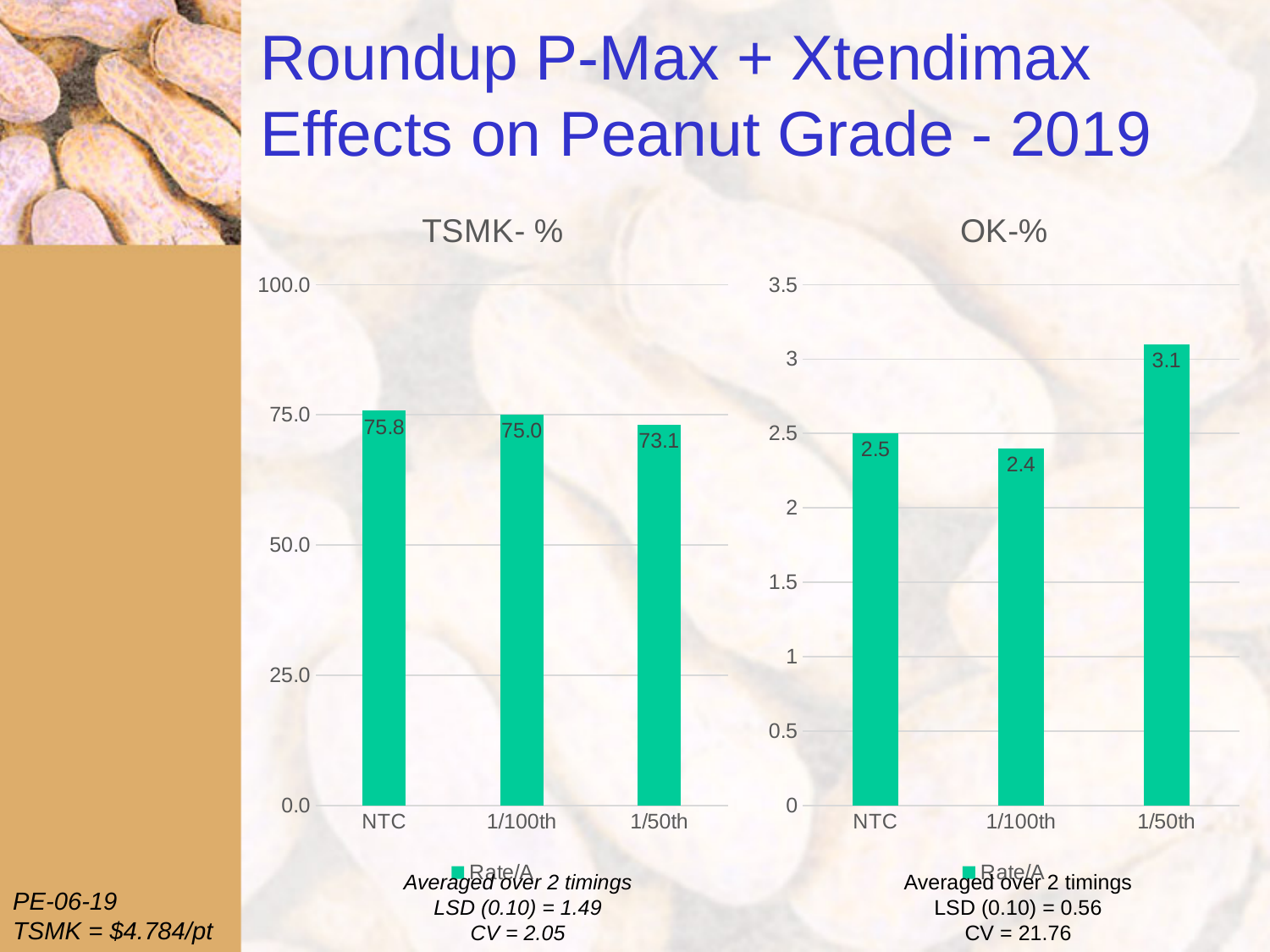
In the OK-% chart, which category has the lowest value? 1/100th In the TSMK- % chart, which category has the highest value? NTC In the OK-% chart, what is the value for 1/50th? 3.1 How many categories are shown on the x axis of the OK-% chart? 3 In the TSMK- % chart, what is the value for NTC? 75.8 What kind of chart is the TSMK- % chart? Bar chart In the TSMK- % chart, what is the difference between the NTC value and the 1/50th value? 2.7 In the OK-% chart, what is the difference between the 1/50th value and the NTC value? 0.6 In the OK-% chart, what is the value for 1/100th? 2.4 In the TSMK- % chart, what is the value for 1/50th? 73.1 What is the legend entry shown below the OK-% chart? Rate/A In the TSMK- % chart, which is larger, the value for 1/100th or the value for 1/50th? 1/100th